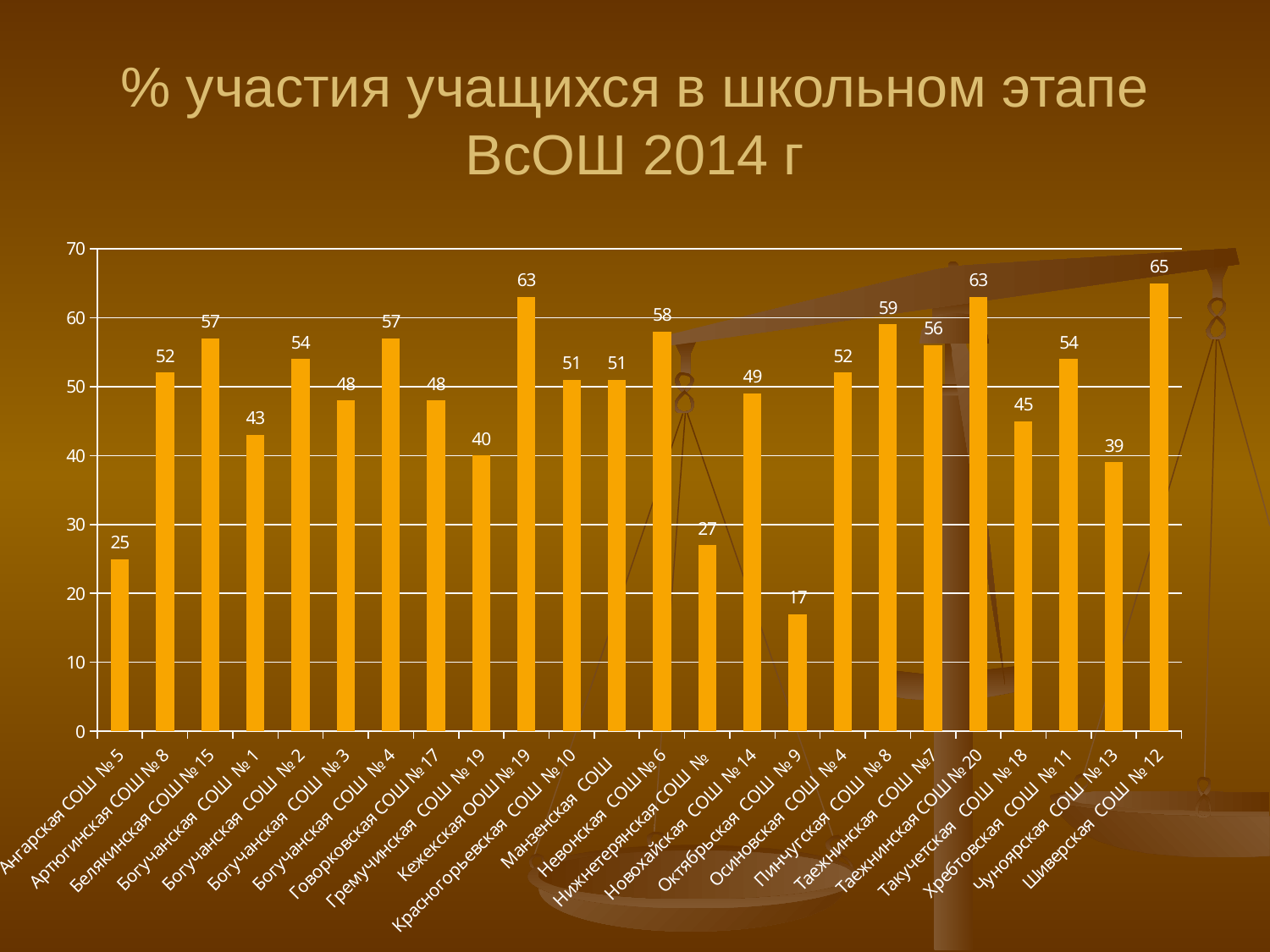
Which school has the highest value? Шиверская СОШ № 12 What kind of chart is shown on the slide? bar chart What is the value for Кежекская ООШ № 19? 63 Which school has the lowest value? Октябрьская СОШ № 9 What is the value for Чуноярская СОШ № 13? 39 What is the difference between the values for Пинчугская СОШ № 8 and Нижнетерянская СОШ №? 32 What is the difference between the values for Шиверская СОШ № 12 and Октябрьская СОШ № 9? 48 Is the value for Такучетская СОШ № 18 greater or less than 50? less How many schools are shown on the x axis? 24 Which is larger, the value for Невонская СОШ № 6 or the value for Гремучинская СОШ № 19? Невонская СОШ № 6 What is the value for Ангарская СОШ № 5? 25 What is the value for Октябрьская СОШ № 9? 17